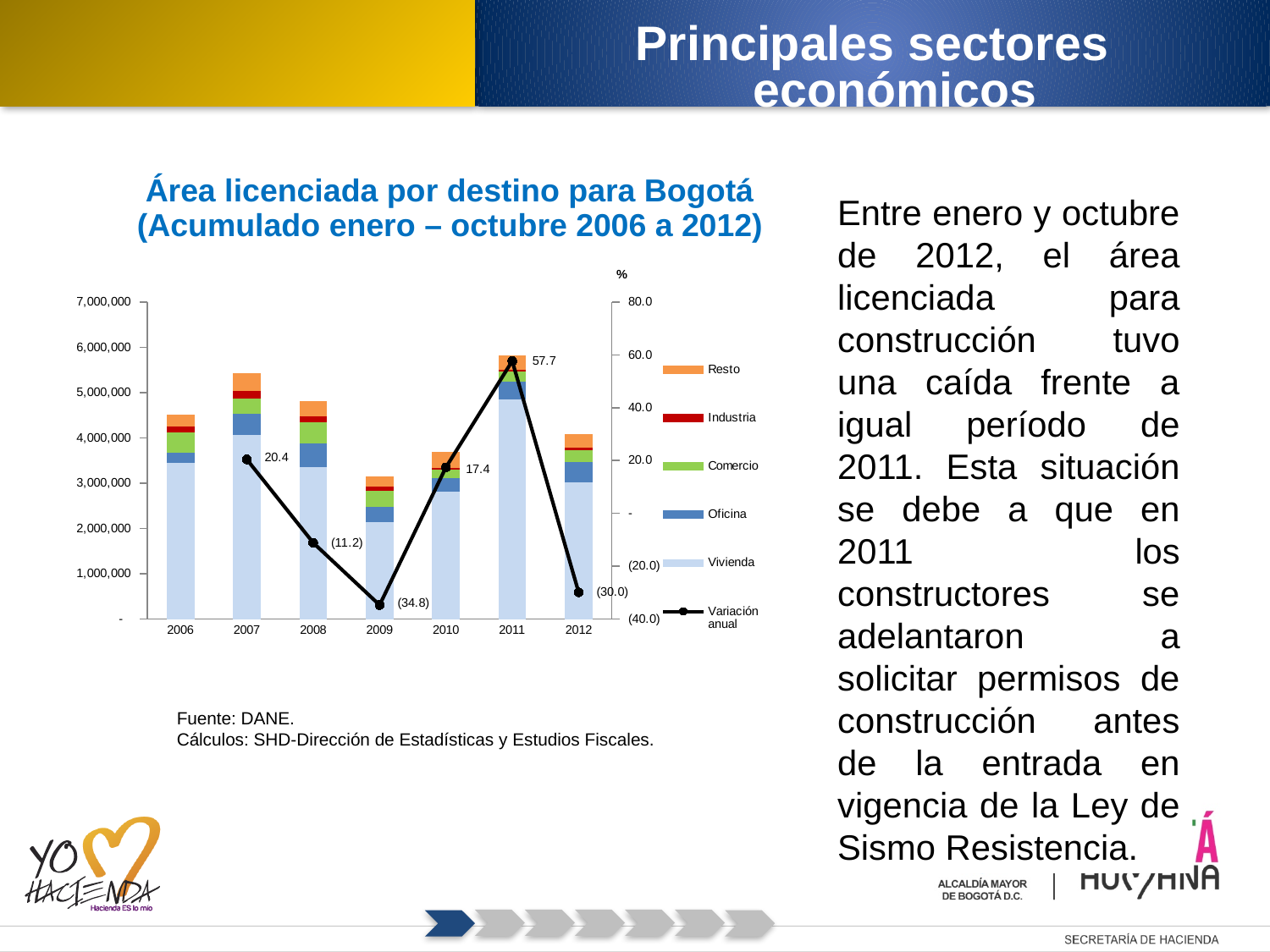
How many years are shown on the x axis? 7 In which year is the Variación anual lowest? 2009 What is the value of Variación anual for 2012? (30.0) In which year is the Variación anual highest? 2011 Which year has the larger Variación anual, 2007 or 2010? 2007 What is the difference between the Variación anual for 2011 and for 2010? 40.3 What kind of chart is shown on the slide? Stacked bar chart with a line Is the total licensed area (stacked bar) for 2011 greater or less than 5,000,000? greater Is the total licensed area (stacked bar) for 2009 greater or less than 4,000,000? less What is the value of Variación anual for 2011? 57.7 What is the value of Variación anual for 2009? (34.8) How many series does the legend list? 6